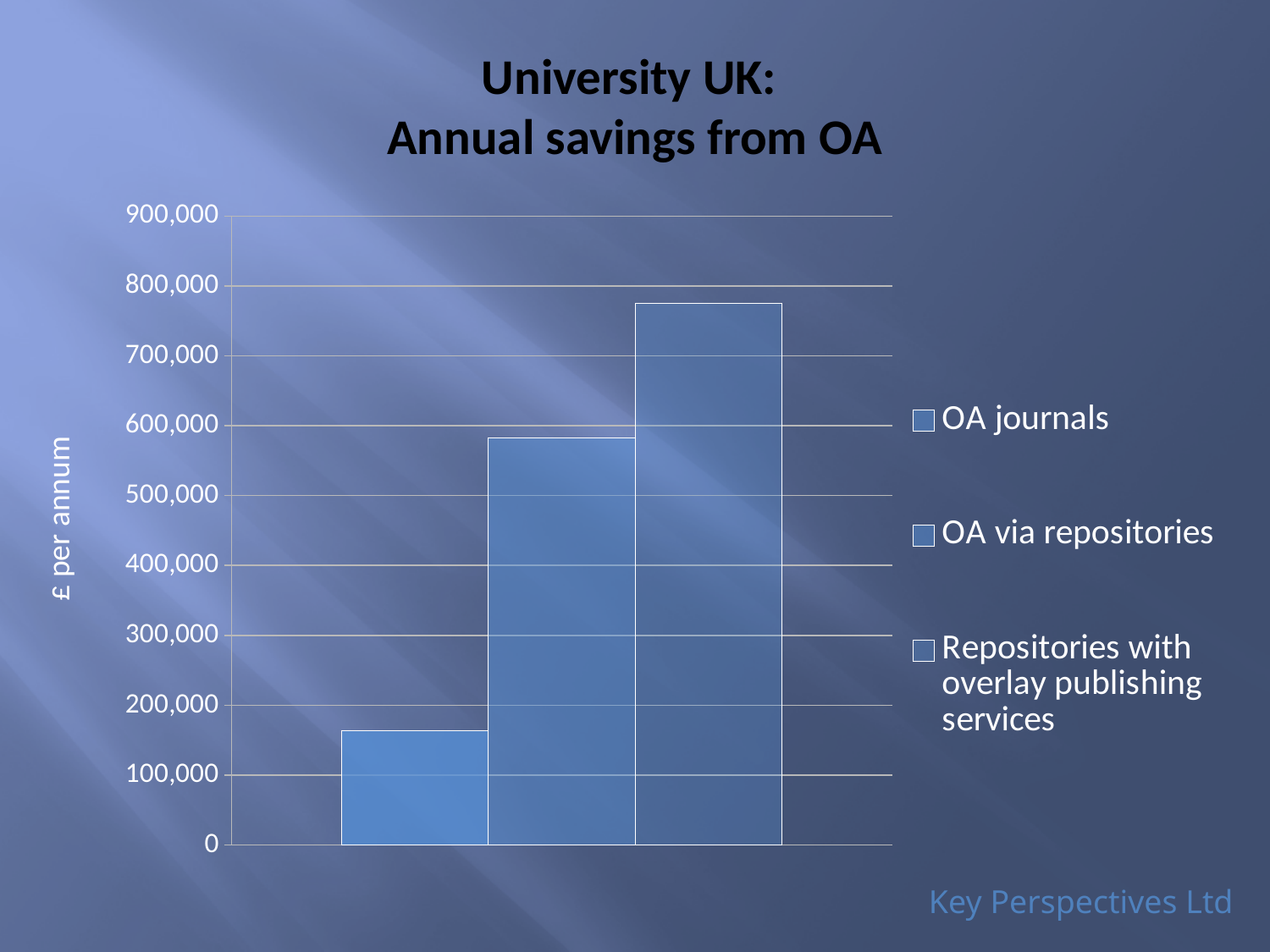
Is the value for OA via repositories greater or less than 500,000? greater What is the label on the vertical axis? £ per annum Which series has the highest annual savings? Repositories with overlay publishing services Is the value for OA journals greater or less than 200,000? less Which is larger, the value for OA journals or the value for OA via repositories? OA via repositories What kind of chart is shown on the slide? bar chart Do the bar values rise or fall from left to right across the chart? rise Is the value for Repositories with overlay publishing services greater or less than 700,000? greater How many series does the legend list? 3 What is the title of the chart? University UK: Annual savings from OA Which series has the lowest annual savings? OA journals Which is larger, the value for OA via repositories or the value for Repositories with overlay publishing services? Repositories with overlay publishing services